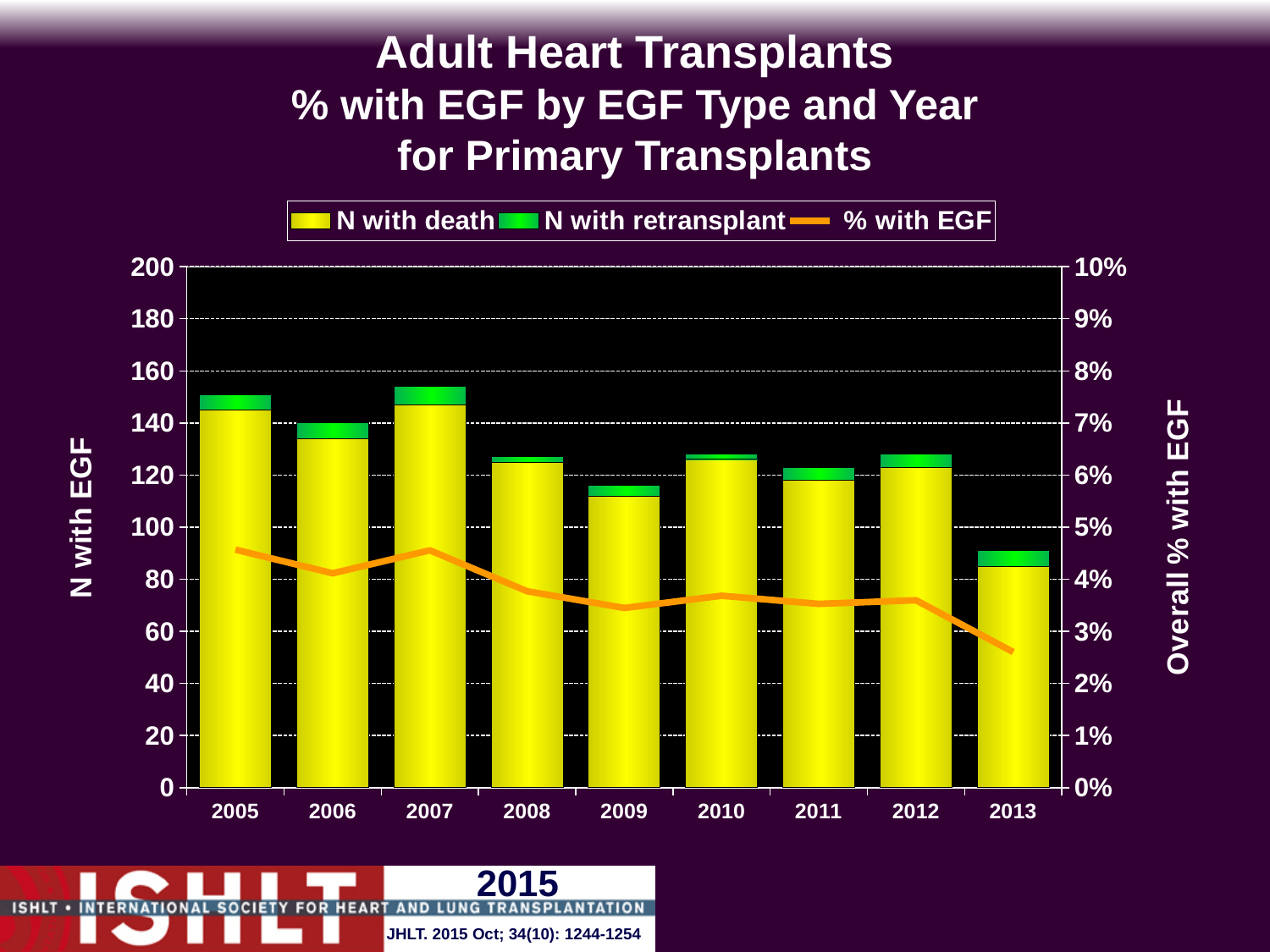
Is the % with EGF value for 2013 greater or less than 3%? less Does the % with EGF line generally rise or fall from 2005 to 2013? fall What is the label of the right-hand y axis? Overall % with EGF Which year has the lowest total N with EGF bar? 2013 What kind of chart is shown on the slide? A combined bar and line chart (stacked bars with a line) Is the % with EGF value for 2005 greater or less than 4%? greater How many years are shown on the x axis of the chart? 9 Is the total N with EGF bar for 2013 greater or less than 100? less How many series does the legend list? 3 Which year has the taller total N with EGF bar, 2009 or 2010? 2010 In which year is the % with EGF line at its lowest? 2013